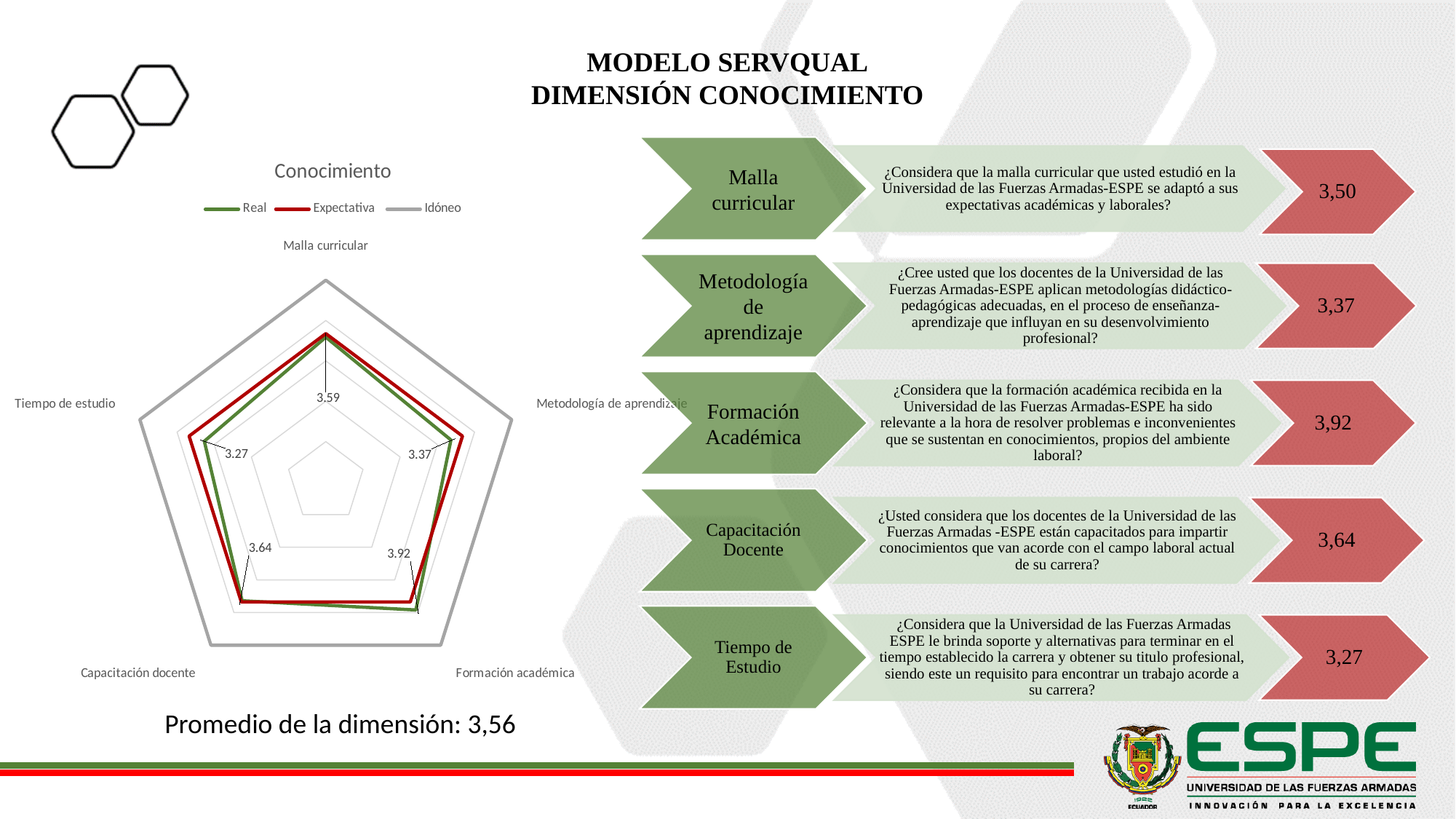
Which category has the highest labelled value in the chart? Formación académica What value is labelled on the Tiempo de estudio axis of the chart? 3.27 How many categories (axes) does the radar chart have? 5 What value is labelled on the Malla curricular axis of the chart? 3.59 What is the difference between the labelled values for Formación académica and Tiempo de estudio? 0.65 What is the title of the chart? Conocimiento What value is labelled on the Formación académica axis of the chart? 3.92 Which series are listed in the chart legend? Real, Expectativa, Idóneo What value is labelled on the Metodología de aprendizaje axis of the chart? 3.37 How many series does the chart legend list? 3 What type of chart is shown on the slide? radar chart Which category has the lowest labelled value in the chart? Tiempo de estudio